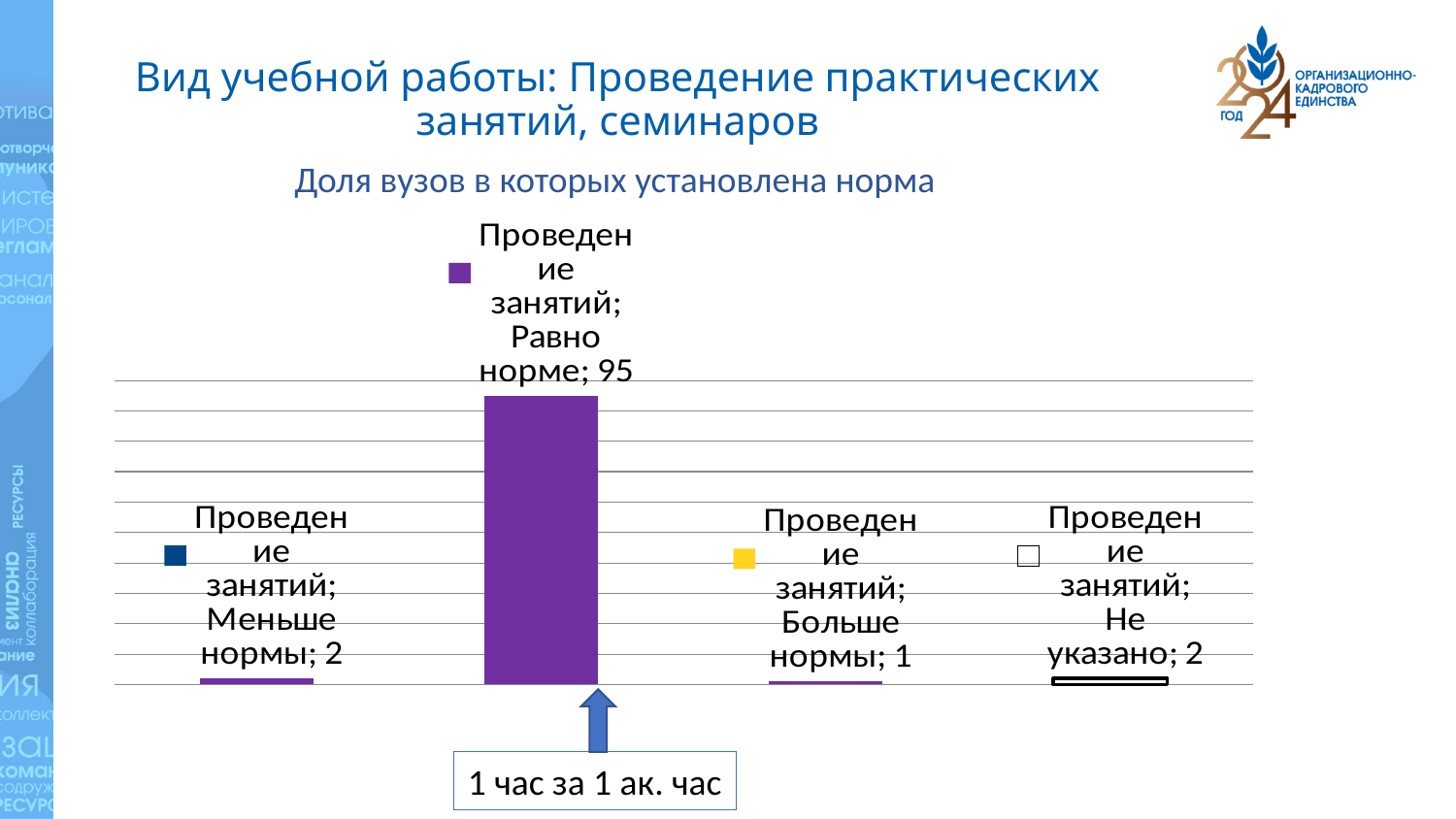
Which category has the lowest value? Больше нормы What is the difference between the values for "Равно норме" and "Меньше нормы"? 93 Which category has the highest value? Равно норме Which is larger, the value for "Меньше нормы" or the value for "Больше нормы"? Меньше нормы What is the value for "Больше нормы"? 1 What is the value for "Не указано"? 2 What is the value for "Меньше нормы"? 2 How many categories are plotted in the chart? 4 What is the title of the chart? Доля вузов в которых установлена норма What is the value for "Равно норме"? 95 What text is in the callout box pointing to the tallest bar? 1 час за 1 ак. час What type of chart is shown on the slide? bar chart